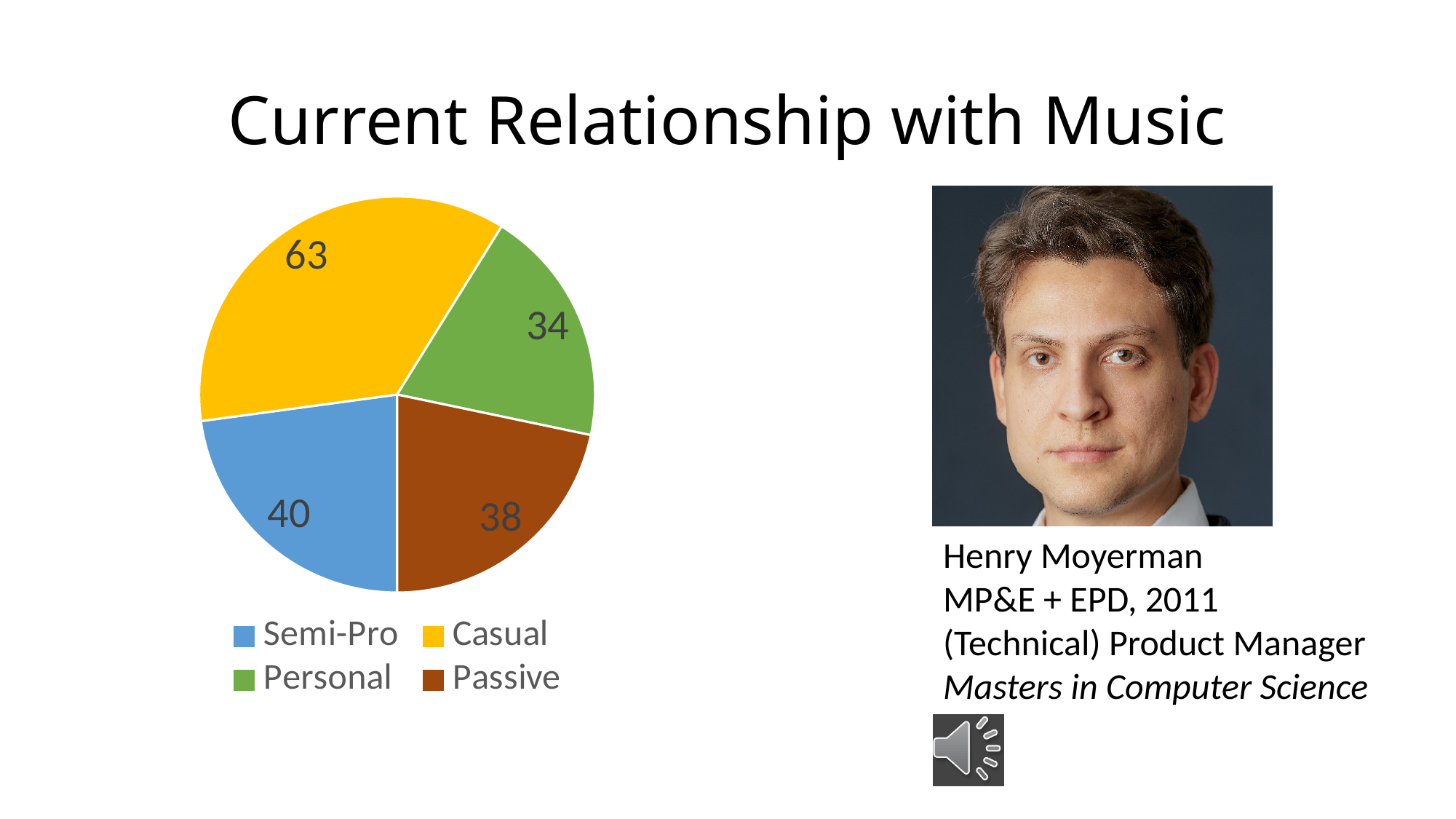
What value is shown for the Passive slice? 38 What is the difference between the Casual and Personal values? 29 Which category has the smallest slice of the pie? Personal What kind of chart is shown on the slide? Pie chart What value is shown for the Casual slice? 63 What colour is the Passive slice in the pie chart? Brown How many categories does the pie chart show? 4 Which is larger, the Semi-Pro value or the Passive value? Semi-Pro What share of the pie does the Casual slice represent? 36% What value is shown for the Semi-Pro slice? 40 What value is shown for the Personal slice? 34 Which category has the largest slice of the pie? Casual